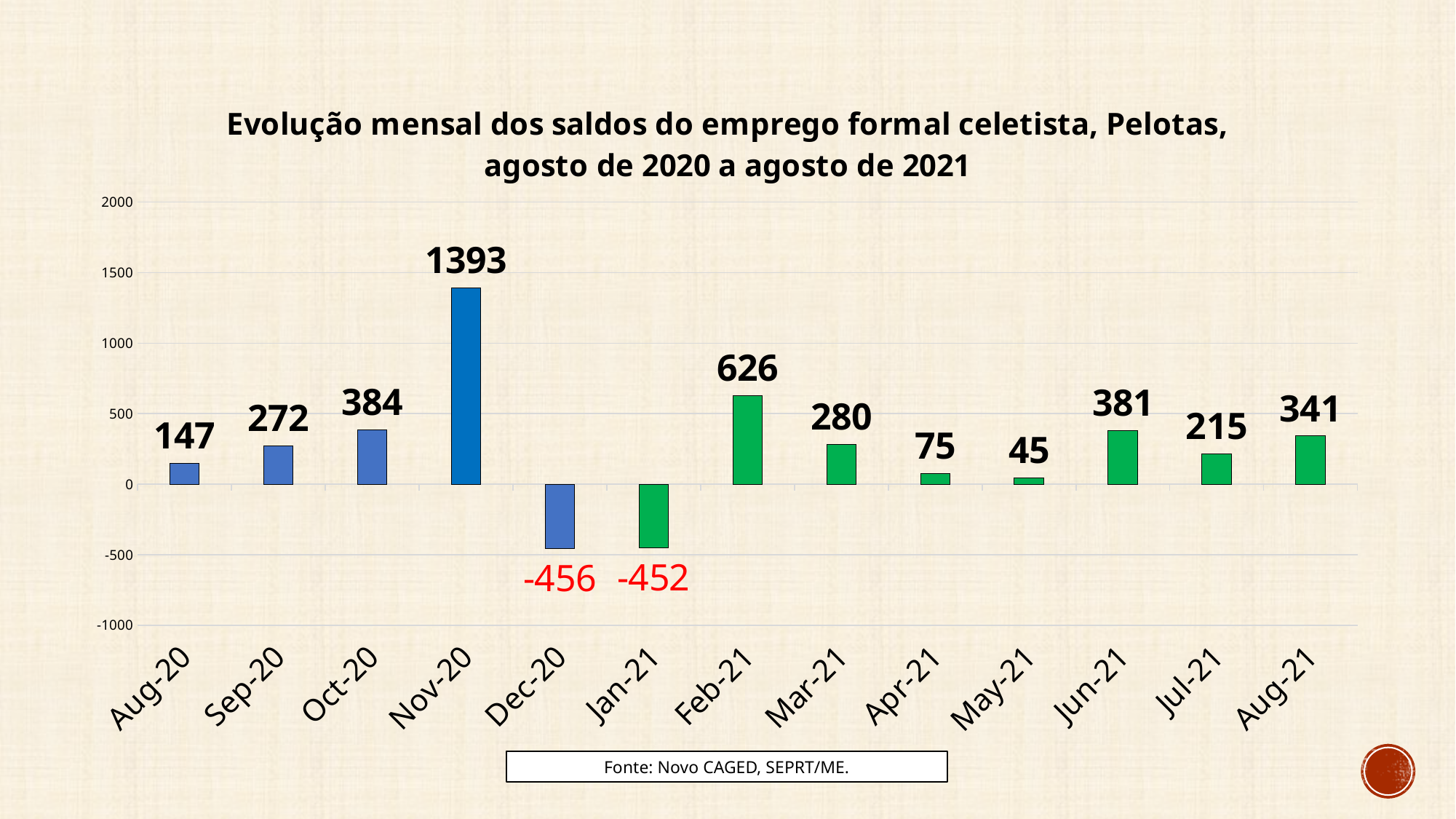
What is the difference between the values for Nov-20 and Feb-21? 767 How many months have a negative value? 2 Which month has the highest value? Nov-20 How many months are shown on the x axis? 13 Which is larger, the value for Jun-21 or the value for Aug-21? Jun-21 What is the value for Dec-20? -456 What is the value for Feb-21? 626 What source is cited below the chart? Novo CAGED, SEPRT/ME. What is the value for May-21? 45 What is the value for Nov-20? 1393 Which month has the lowest value? Dec-20 What kind of chart is shown on the slide? Bar chart